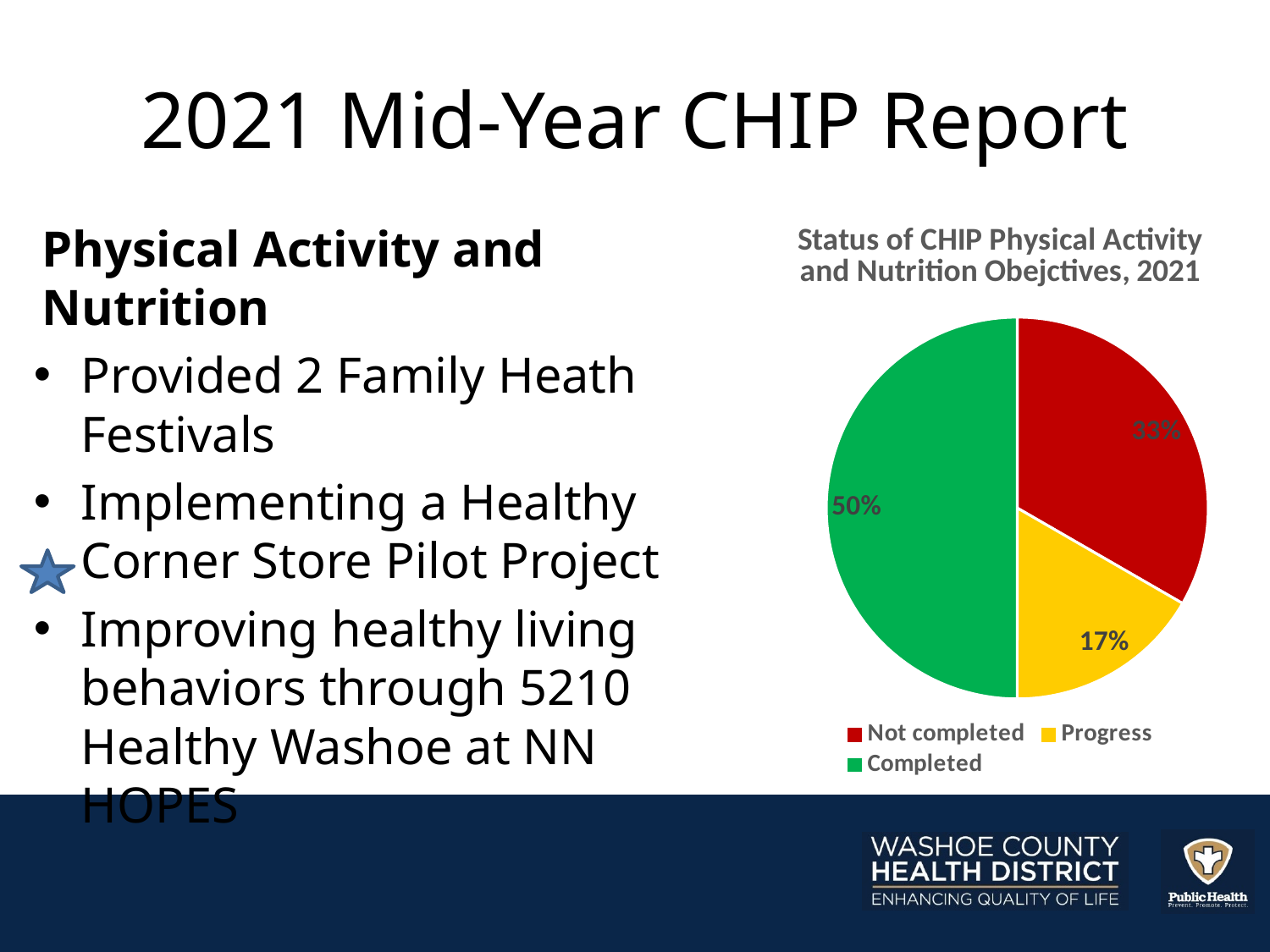
Which is larger, the Not completed slice or the Progress slice? Not completed Which category has the largest slice of the pie? Completed What kind of chart is shown on the slide? pie chart What colour is the Completed slice? green What share of the pie is labelled Progress? 17% Which category has the smallest slice of the pie? Progress How many slices does the pie chart have? 3 What share of the pie is labelled Completed? 50% How many entries does the legend list? 3 What is the title of the chart? Status of CHIP Physical Activity and Nutrition Obejctives, 2021 What share of the pie is labelled Not completed? 33% What is the difference in percentage points between the Completed slice and the Not completed slice? 17